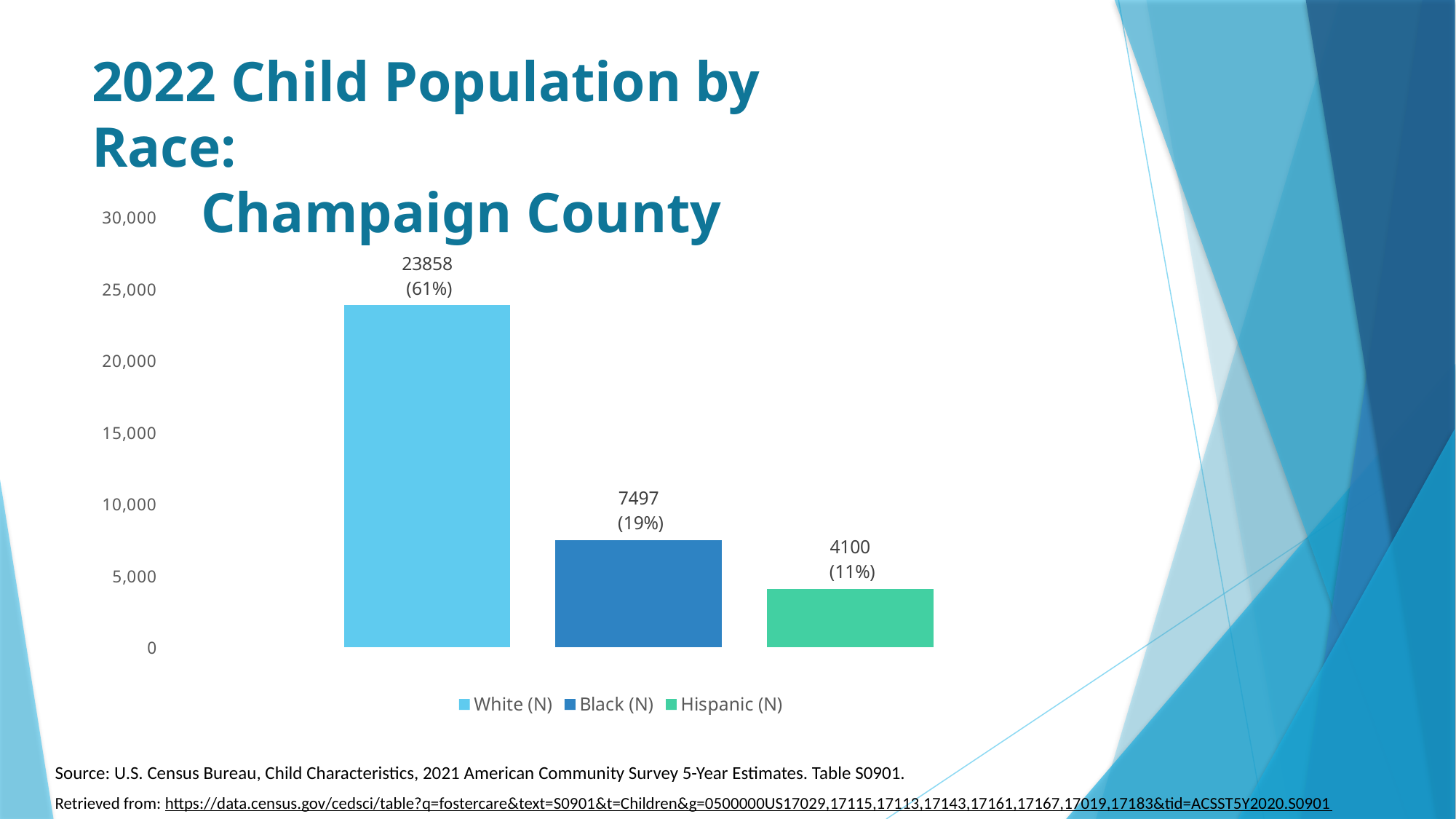
What is the value for White (N)? 23858 What is the title of the chart? 2022 Child Population by Race: Champaign County Which group has the highest child population? White (N) What percentage is shown for Black (N)? 19% Which is larger, the value for Black (N) or Hispanic (N)? Black (N) Which group has the lowest child population? Hispanic (N) What is the value for Hispanic (N)? 4100 What is the difference between the values for Black (N) and Hispanic (N)? 3397 What kind of chart is shown on the slide? Bar chart What is the difference between the values for White (N) and Black (N)? 16361 What is the value for Black (N)? 7497 How many series does the legend list? 3